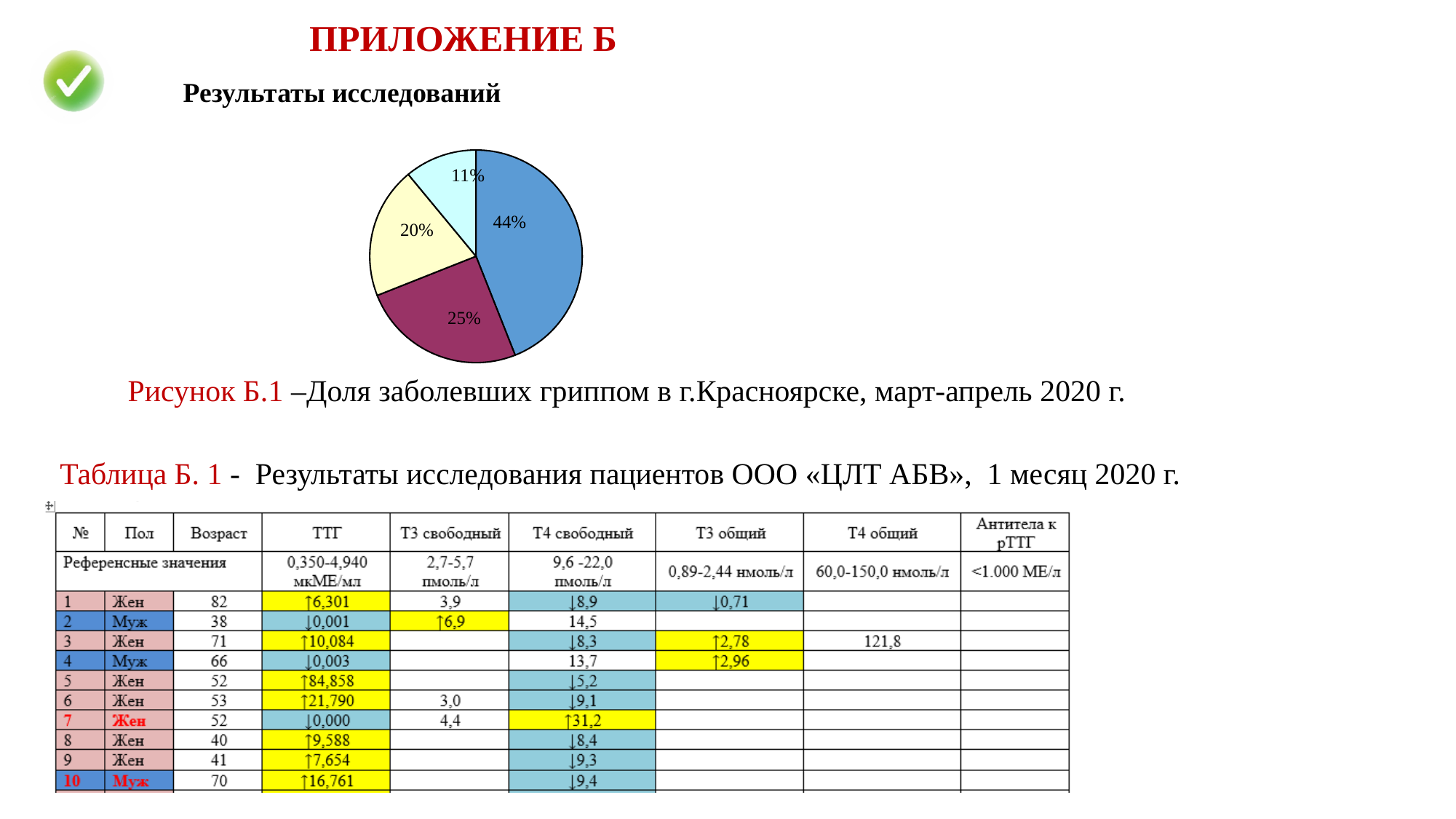
What is the caption of the pie chart figure? Рисунок Б.1 – Доля заболевших гриппом в г.Красноярске, март-апрель 2020 г. What percentage is shown on the blue slice of the pie chart? 44% What is the difference between the largest and smallest slices of the pie chart? 33 percentage points What percentage is shown on the dark magenta slice of the pie chart? 25% Does the pie chart include a legend? No What percentage is shown on the light cyan slice of the pie chart? 11% What is the largest share shown in the pie chart? 44% Which slice is larger in the pie chart, the magenta one or the light yellow one? the magenta one (25%) How many slices does the pie chart have? 4 What percentage is shown on the light yellow slice of the pie chart? 20% What kind of chart is shown in Рисунок Б.1? pie chart What is the smallest share shown in the pie chart? 11%